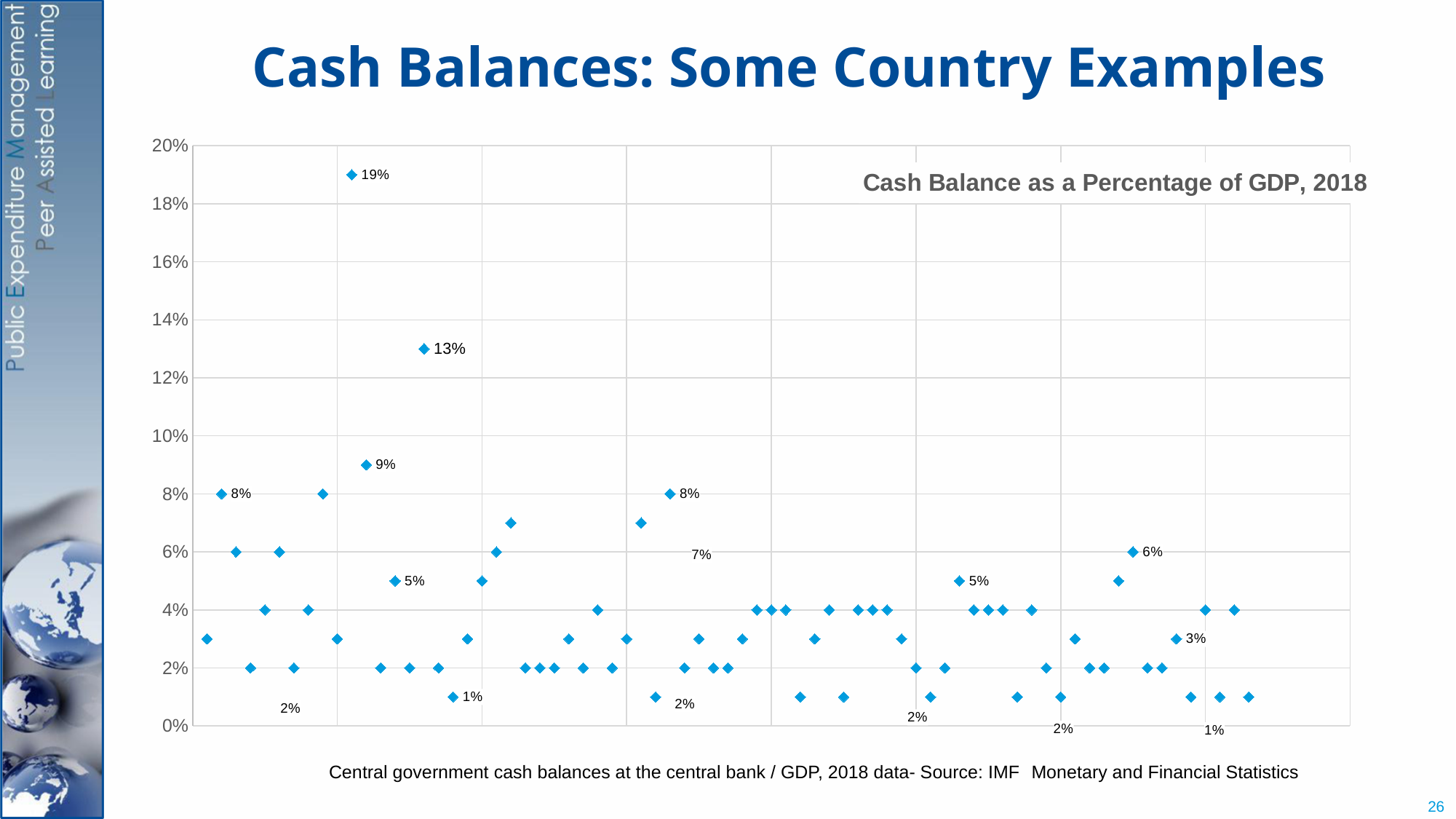
What is the highest cash balance value plotted on the chart? 19% Is the point labelled 13% greater or less than 14%? less Which is larger, the point labelled 9% or the point labelled 6%? 9% What is the title of the chart? Cash Balance as a Percentage of GDP, 2018 What is the second-highest labelled value on the chart? 13% Is the highest plotted point greater or less than 18%? greater What kind of chart is shown on the slide? Scatter chart Which year does the chart's data refer to? 2018 What is the difference between the highest labelled value (19%) and the second-highest labelled value (13%)? 6 percentage points What is the lowest labelled value shown on the chart? 1% How many points on the chart lie above 10%? 2 What is the maximum value shown on the vertical axis? 20%